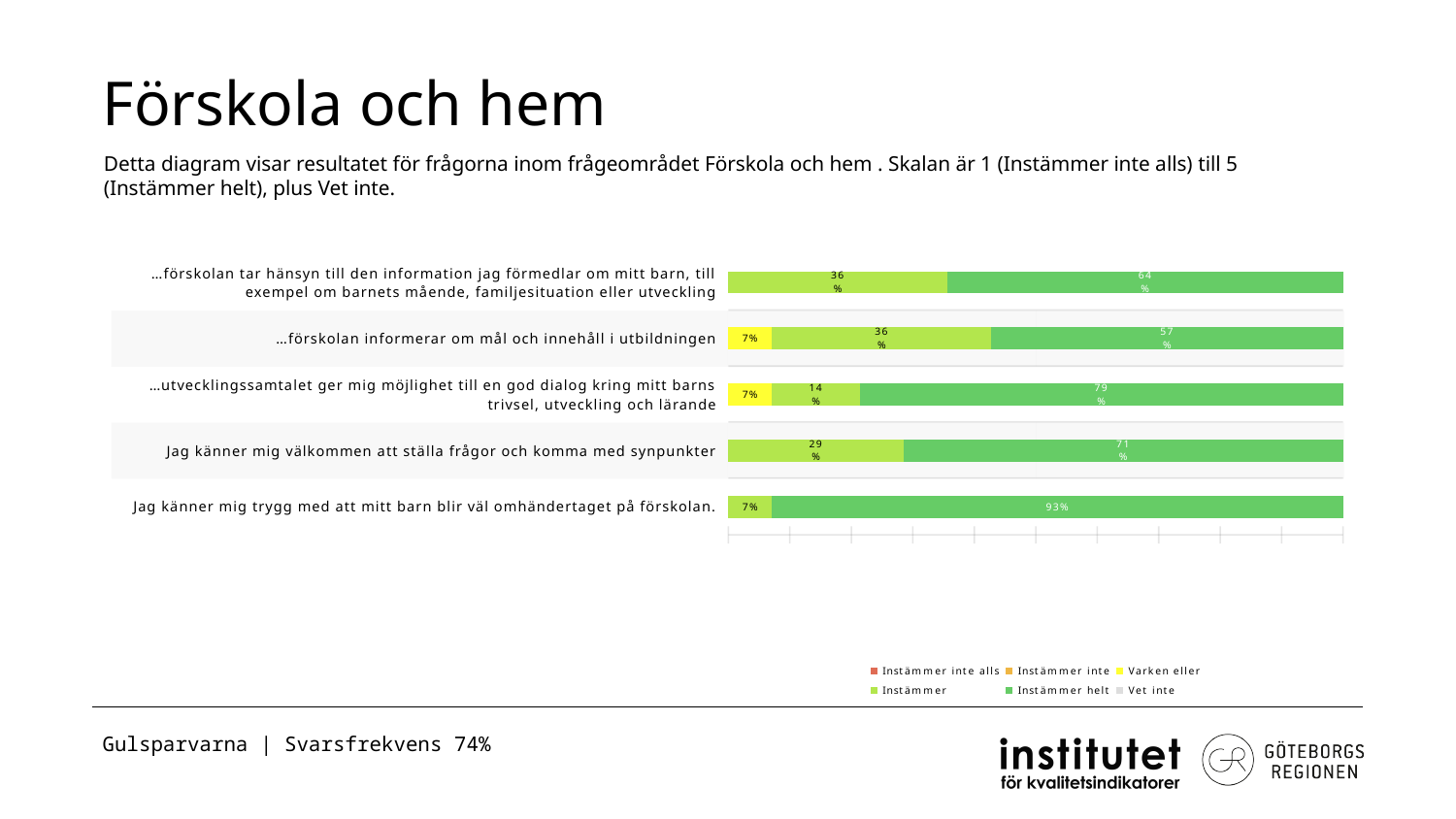
What kind of chart is shown on the slide? stacked bar chart What is the 'Instämmer helt' share for '…utvecklingssamtalet ger mig möjlighet till en god dialog kring mitt barns trivsel, utveckling och lärande'? 79% Which statement has the lowest 'Instämmer helt' share? …förskolan informerar om mål och innehåll i utbildningen What is the difference between the 'Instämmer helt' shares for 'Jag känner mig välkommen att ställa frågor och komma med synpunkter' and '…förskolan informerar om mål och innehåll i utbildningen'? 14% How many series does the legend list? 6 Which is larger: the 'Instämmer' share for 'Jag känner mig välkommen att ställa frågor och komma med synpunkter' or for '…utvecklingssamtalet ger mig möjlighet till en god dialog kring mitt barns trivsel, utveckling och lärande'? Jag känner mig välkommen att ställa frågor och komma med synpunkter What is the 'Instämmer' share for '…förskolan tar hänsyn till den information jag förmedlar om mitt barn, till exempel om barnets mående, familjesituation eller utveckling'? 36% What is the 'Instämmer helt' share for 'Jag känner mig trygg med att mitt barn blir väl omhändertaget på förskolan'? 93% What is the 'Varken eller' share for '…förskolan informerar om mål och innehåll i utbildningen'? 7% What is the combined share of 'Instämmer' and 'Instämmer helt' for '…förskolan informerar om mål och innehåll i utbildningen'? 93% How many statements (categories) are plotted in the chart? 5 Which statement has the highest 'Instämmer helt' share? Jag känner mig trygg med att mitt barn blir väl omhändertaget på förskolan